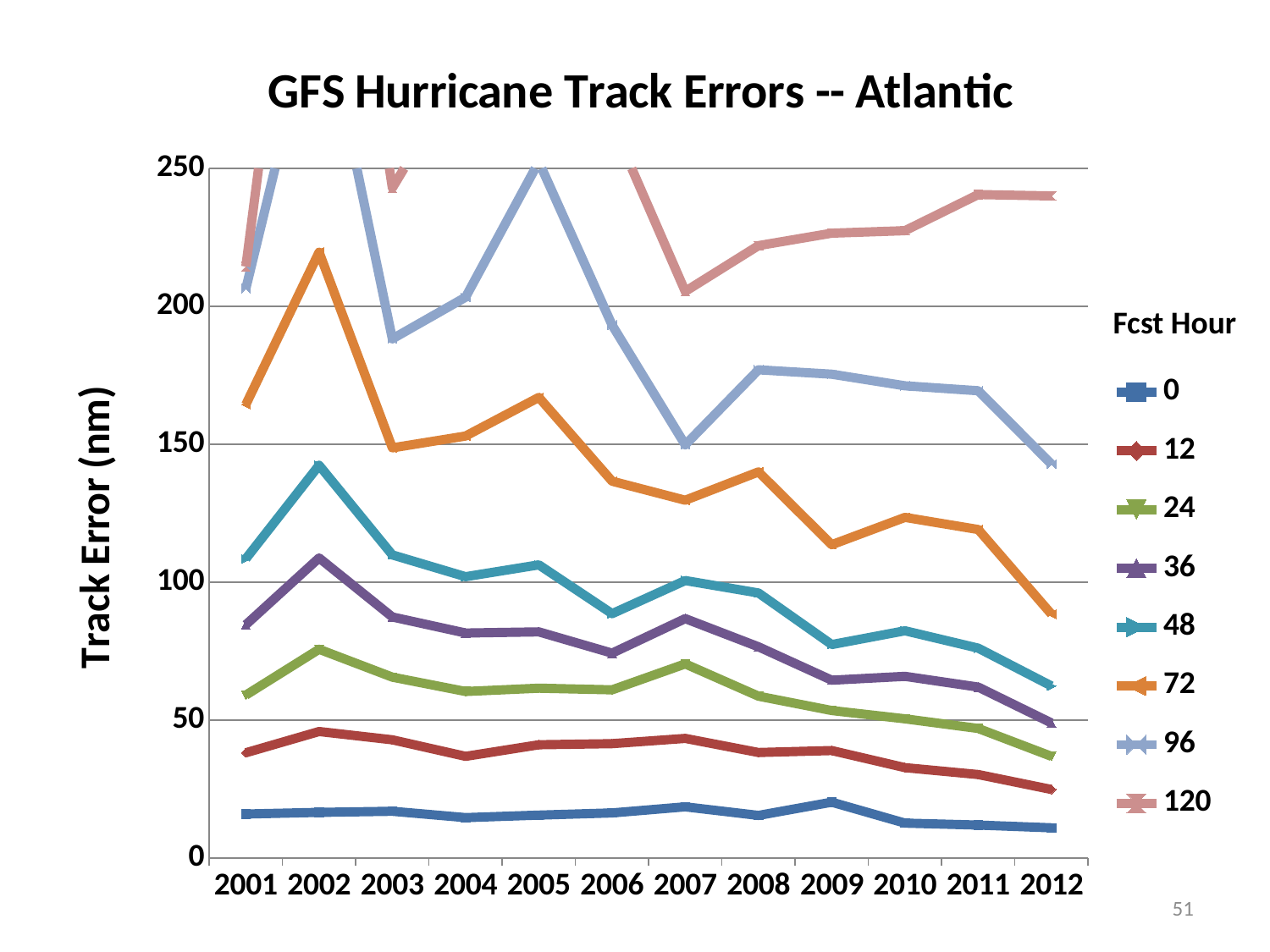
What is the label on the y axis? Track Error (nm) Is the value for the 72-hour series in 2012 greater or less than 100? less In 2012, which is larger: the 36-hour series or the 24-hour series? 36 Which forecast hour series has the lowest track errors across all years? 0 How many series does the legend list under Fcst Hour? 8 How many years are shown along the x axis? 12 Is the value for the 120-hour series in 2011 greater or less than 200? greater In which year does the 72-hour series reach its highest value? 2002 Is the value for the 72-hour series in 2002 greater or less than 200? greater What kind of chart is shown on the slide? line chart What is the title of the chart? GFS Hurricane Track Errors -- Atlantic